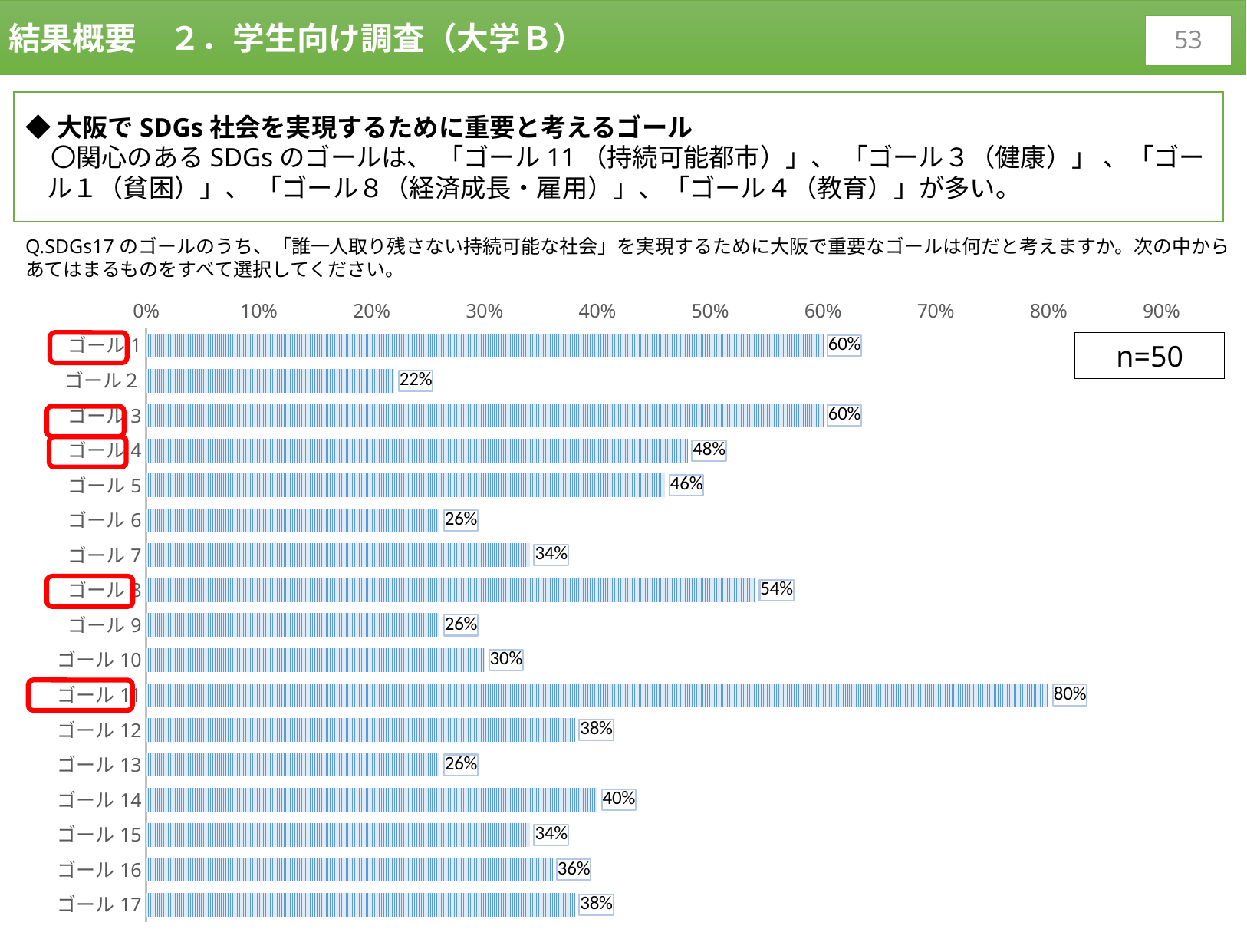
Which goal has the highest value? ゴール 11 What is the value for ゴール 14? 40% What is the difference between the values for ゴール 4 and ゴール 5? 2% What is the difference between the values for ゴール 11 and ゴール 1? 20% What kind of chart is shown on the slide? Bar chart What is the value for ゴール 2? 22% What is the value for ゴール 8? 54% Which is larger, the value for ゴール 7 or the value for ゴール 12? ゴール 12 Which goal has the lowest value? ゴール 2 How many goals (categories) are shown in the chart? 17 What sample size (n) is shown next to the chart? n=50 What is the value for ゴール 11? 80%